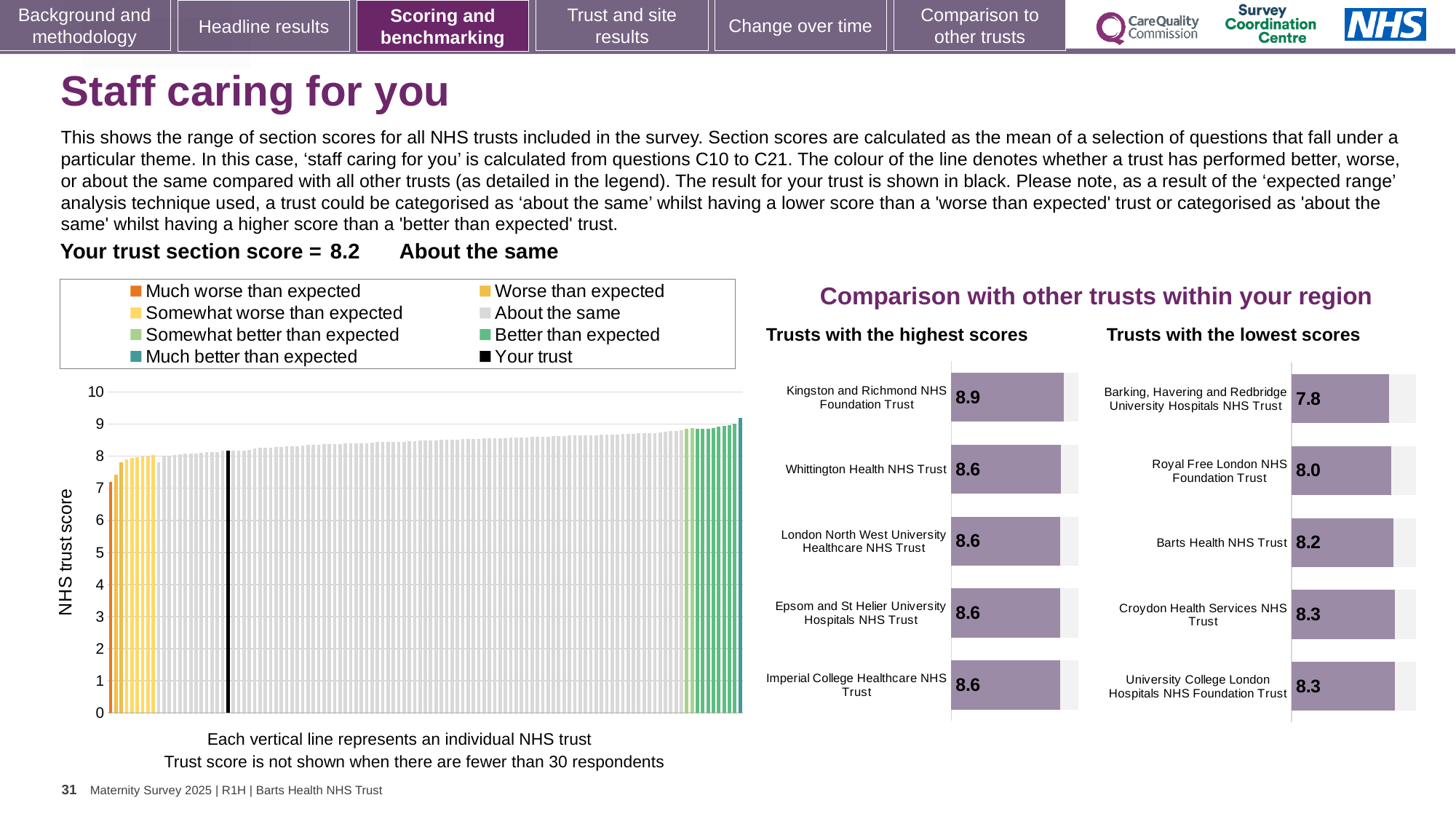
In the 'Trusts with the lowest scores' chart, what is the score for Barts Health NHS Trust? 8.2 How many trusts are shown in the 'Trusts with the highest scores' chart? 5 What kind of chart is the main 'NHS trust score' chart on the left of the slide? Bar chart How many entries does the legend of the main 'NHS trust score' chart list? 8 In the 'Trusts with the highest scores' chart, which trust has the highest score? Kingston and Richmond NHS Foundation Trust In the main 'NHS trust score' chart, do the bar heights rise or fall from left to right? Rise In the 'Trusts with the lowest scores' chart, what is the score for Barking, Havering and Redbridge University Hospitals NHS Trust? 7.8 In the 'Trusts with the lowest scores' chart, which trust has the lowest score? Barking, Havering and Redbridge University Hospitals NHS Trust In the 'Trusts with the lowest scores' chart, what is the difference between the scores for Croydon Health Services NHS Trust and Royal Free London NHS Foundation Trust? 0.3 What is the difference between the score for Kingston and Richmond NHS Foundation Trust in the highest scores chart and the score for Barking, Havering and Redbridge University Hospitals NHS Trust in the lowest scores chart? 1.1 In the 'Trusts with the lowest scores' chart, which has the larger score: Royal Free London NHS Foundation Trust or University College London Hospitals NHS Foundation Trust? University College London Hospitals NHS Foundation Trust In the 'Trusts with the highest scores' chart, what is the score for Kingston and Richmond NHS Foundation Trust? 8.9